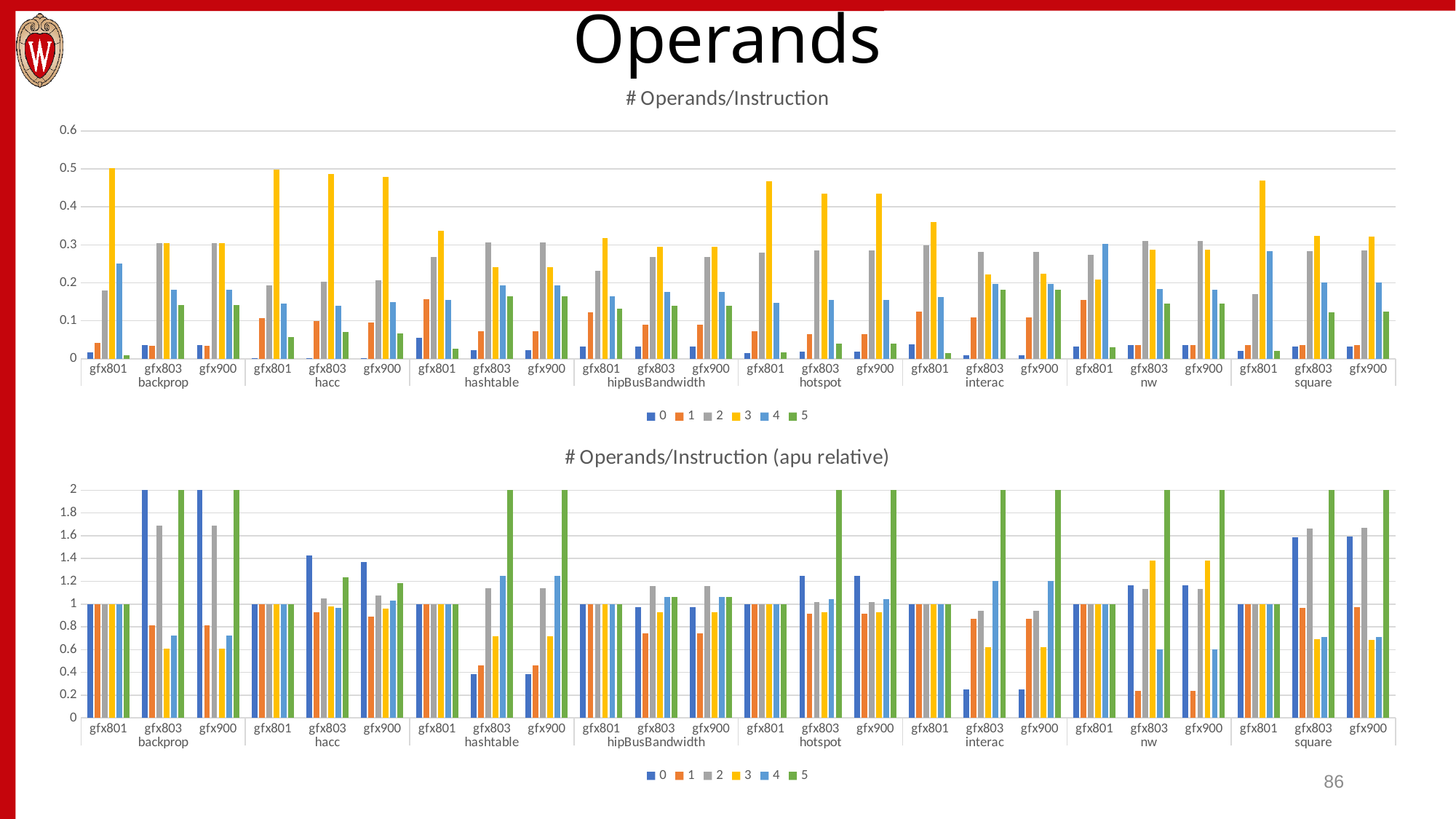
What kind of chart is the top chart titled "# Operands/Instruction"? bar chart What is the title of the bottom chart? # Operands/Instruction (apu relative) How many benchmark groups are shown along the x axis of the top chart "# Operands/Instruction"? 8 In the top chart "# Operands/Instruction", which is larger for gfx801 under nw: series 2 or series 4? series 4 In the bottom chart "# Operands/Instruction (apu relative)", what is the value for series 0 at gfx801 under backprop? 1 In the bottom chart "# Operands/Instruction (apu relative)", which is larger for gfx803 under nw: series 1 or series 3? series 3 In the top chart "# Operands/Instruction", which series has the highest bar for gfx801 under backprop? 3 In the bottom chart "# Operands/Instruction (apu relative)", is the value for series 0 at gfx803 under interac greater or less than 0.4? less How many series does the legend of the top chart "# Operands/Instruction" list? 6 In the top chart "# Operands/Instruction", is the value for series 5 at gfx801 under backprop greater or less than 0.1? less In the top chart "# Operands/Instruction", is the value for series 3 at gfx801 under hacc greater or less than 0.4? greater